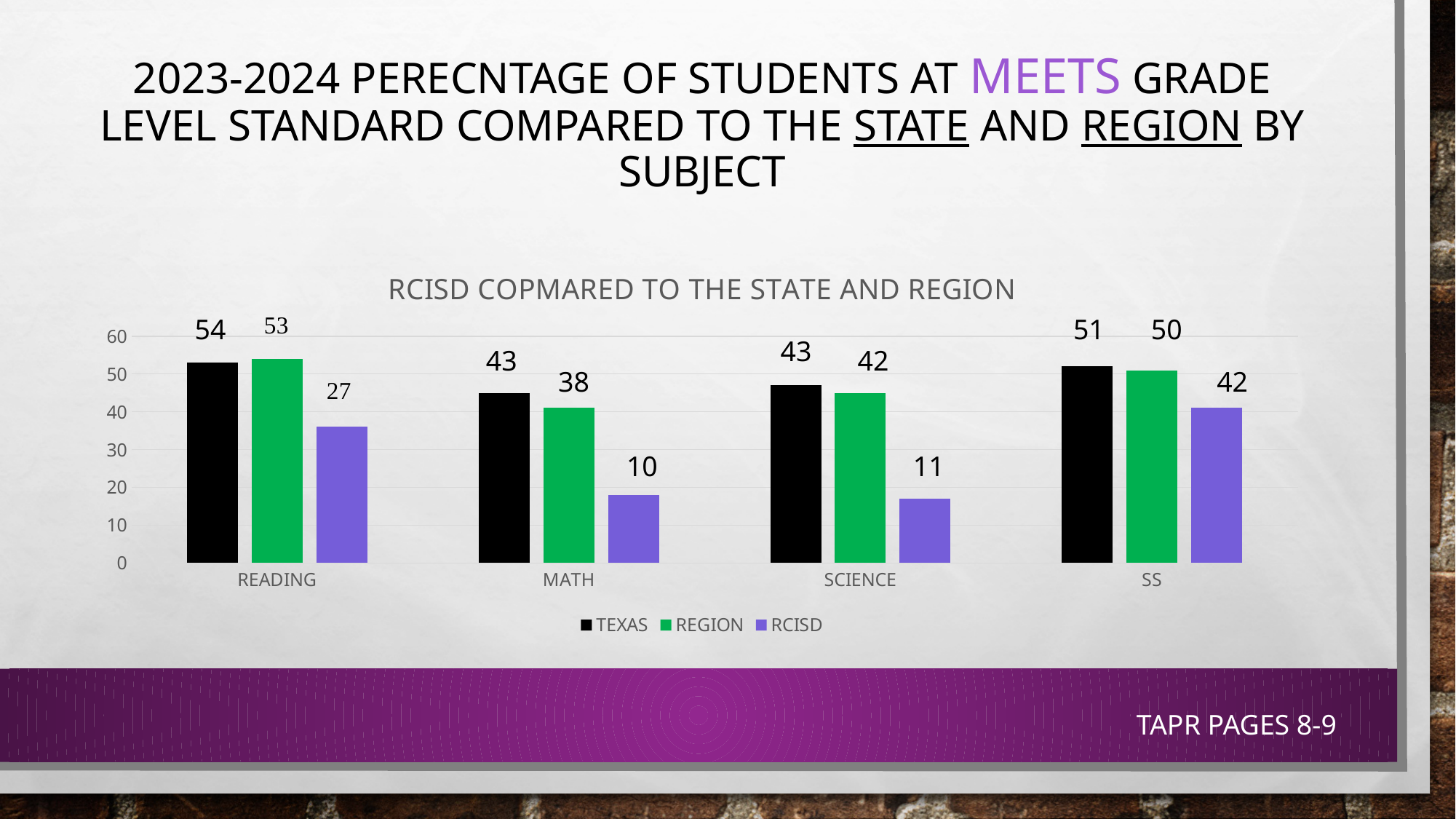
What is the difference between the Texas and RCISD values for Math? 33 How many series does the legend list? 3 What is the Texas value for Math? 43 How many subjects are shown on the x axis? 4 What is the Region value for SS? 50 What is the RCISD value for Reading? 27 What is the title of the chart? RCISD COPMARED TO THE STATE AND REGION What kind of chart is shown on the slide? bar chart What is the RCISD value for Science? 11 Which is larger for Math, the Texas value or the Region value? Texas What is the difference between the Region and RCISD values for SS? 8 In which subject does RCISD have its highest value? SS